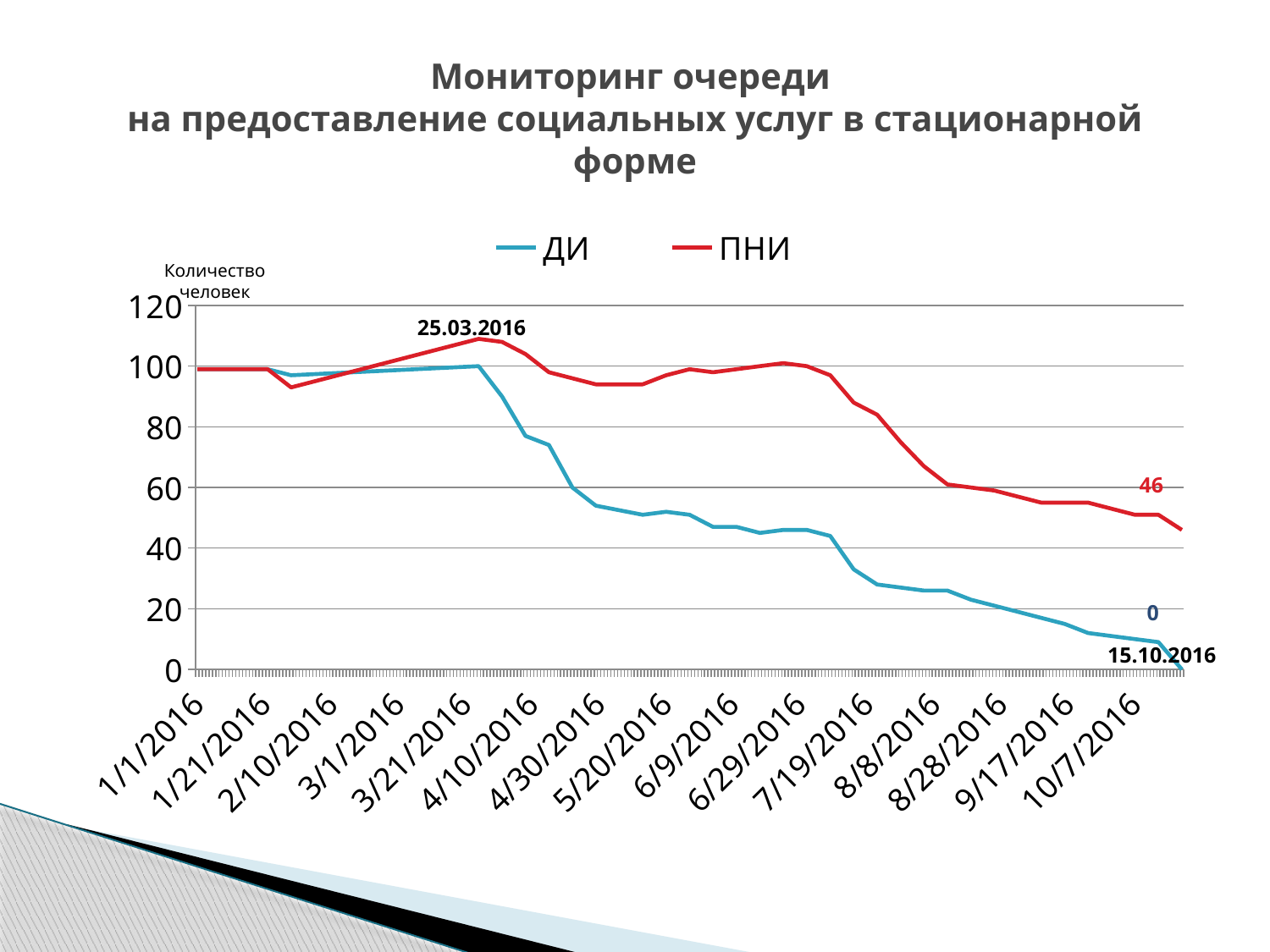
Is the value of the ДИ series at 6/9/2016 greater or less than 60? less Is the value of the ПНИ series at 8/8/2016 greater or less than 80? less What date is annotated at the peak of the ПНИ series? 25.03.2016 What are the two series named in the legend? ДИ and ПНИ What is the final labelled value of the ДИ series? 0 At the end of the period, which series has the larger value, ДИ or ПНИ? ПНИ How many series does the legend list? 2 What is the difference between the final labelled values of ПНИ and ДИ? 46 What is the final labelled value of the ПНИ series? 46 Is the value of the ПНИ series at 5/20/2016 greater or less than 80? greater What kind of chart is shown on the slide? line chart Do the values of the ДИ series rise or fall overall from January to October 2016? fall